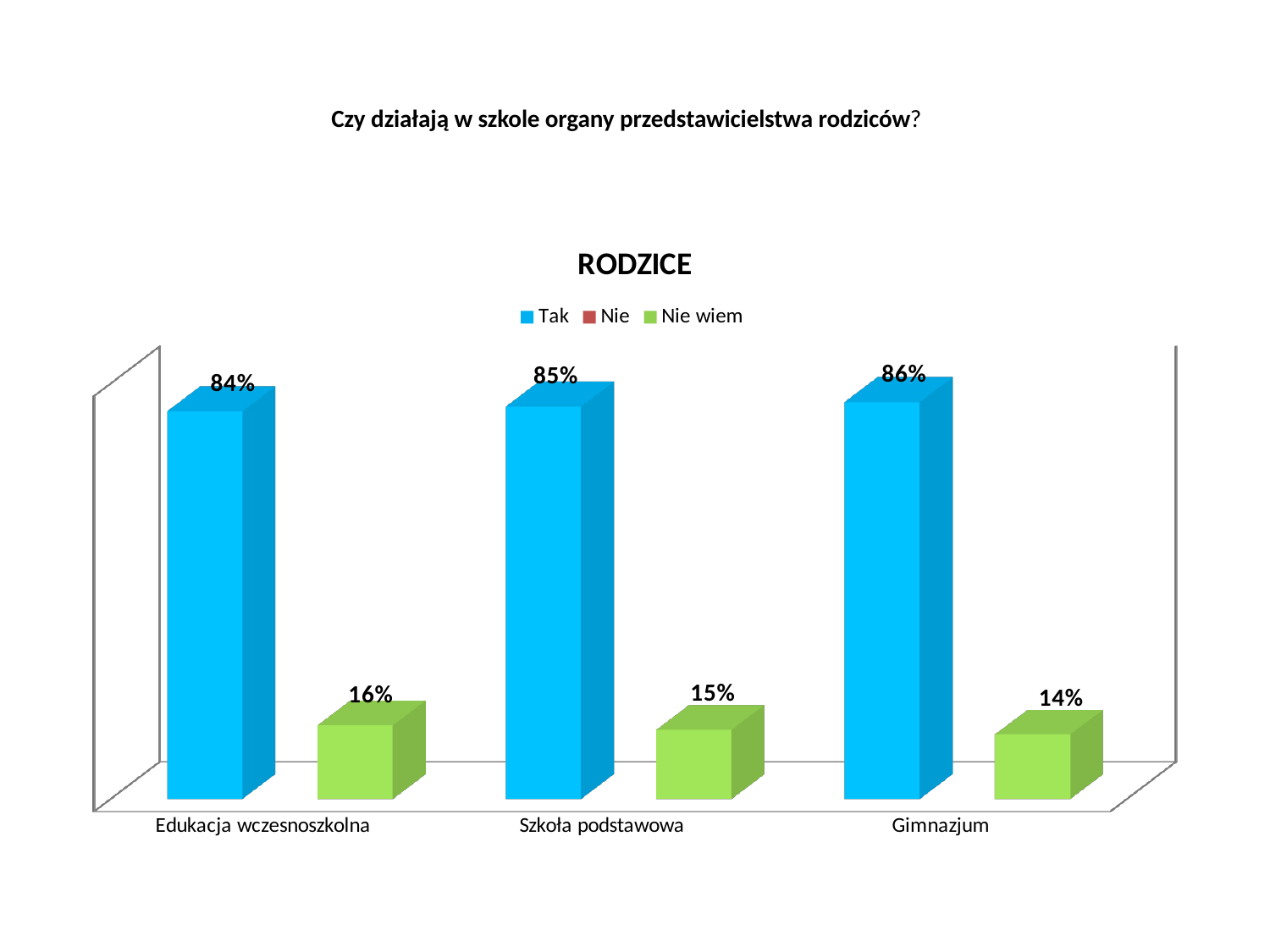
What is the value for Tak in the Szkoła podstawowa category? 85% What is the value for Nie wiem in the Gimnazjum category? 14% What is the difference between the Tak and Nie wiem values for Szkoła podstawowa? 70% What is the value for Nie wiem in the Edukacja wczesnoszkolna category? 16% Which category has the highest value for Tak? Gimnazjum What is the value for Tak in the Gimnazjum category? 86% What kind of chart is shown on the slide? Bar chart What is the title of the chart? RODZICE Which is larger: the Nie wiem value for Edukacja wczesnoszkolna or for Szkoła podstawowa? Edukacja wczesnoszkolna How many series does the legend list? 3 Which category has the lowest value for Nie wiem? Gimnazjum How many categories are shown on the x axis? 3